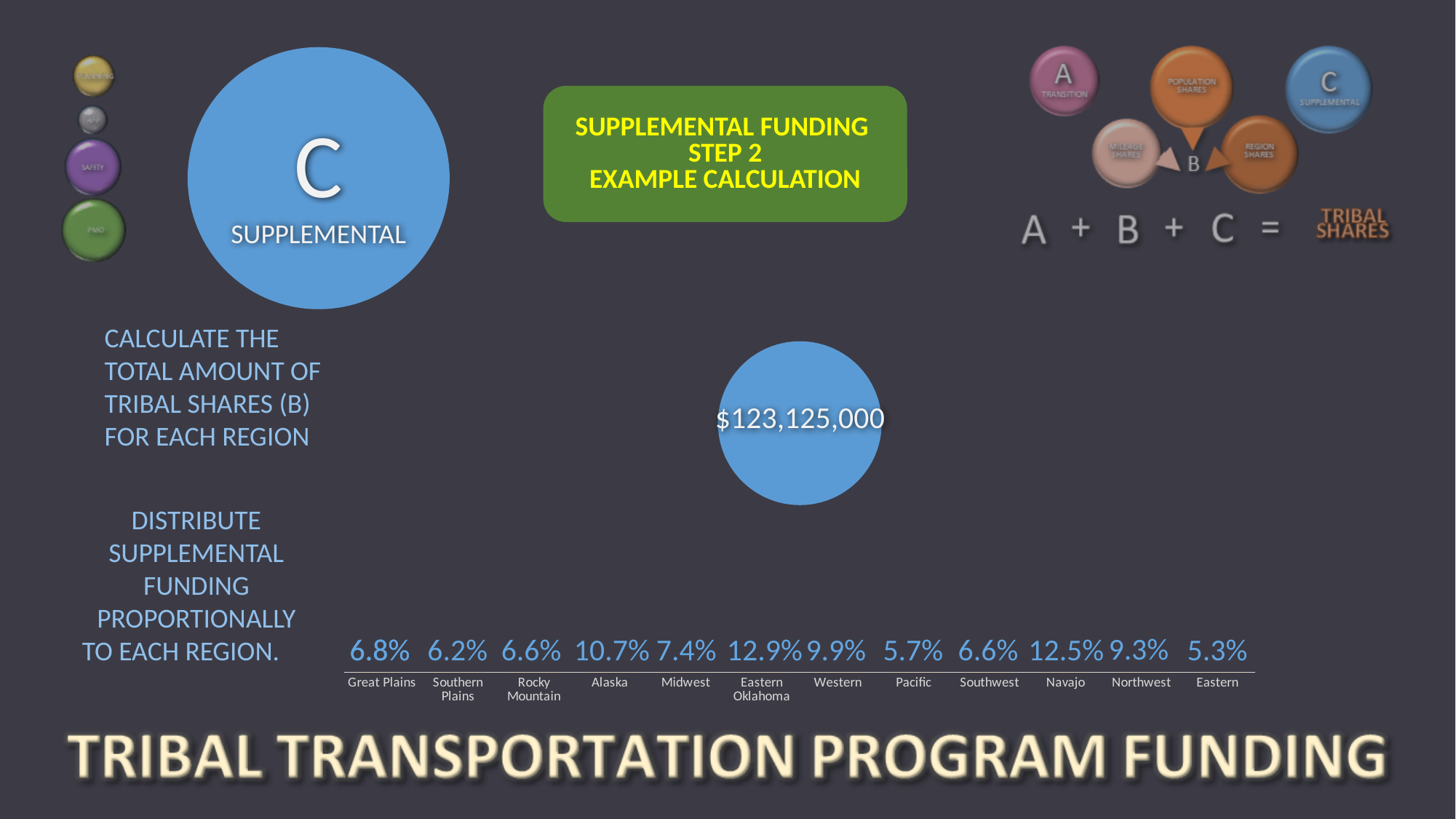
Which is larger, the value for Navajo or the value for Alaska? Navajo Which region has the highest value in the chart? Eastern Oklahoma What is the difference between the values for Alaska and Midwest? 3.3% Which is larger, the value for Southern Plains or the value for Midwest? Midwest What is the value shown for Navajo? 12.5% What is the value shown for Great Plains? 6.8% Which region has the lowest value in the chart? Eastern What total amount is shown in the blue circle above the chart? $123,125,000 What is the value shown for Pacific? 5.7% What is the difference between the values for Western and Northwest? 0.6% How many regions are shown in the chart? 12 What is the value shown for Eastern Oklahoma? 12.9%